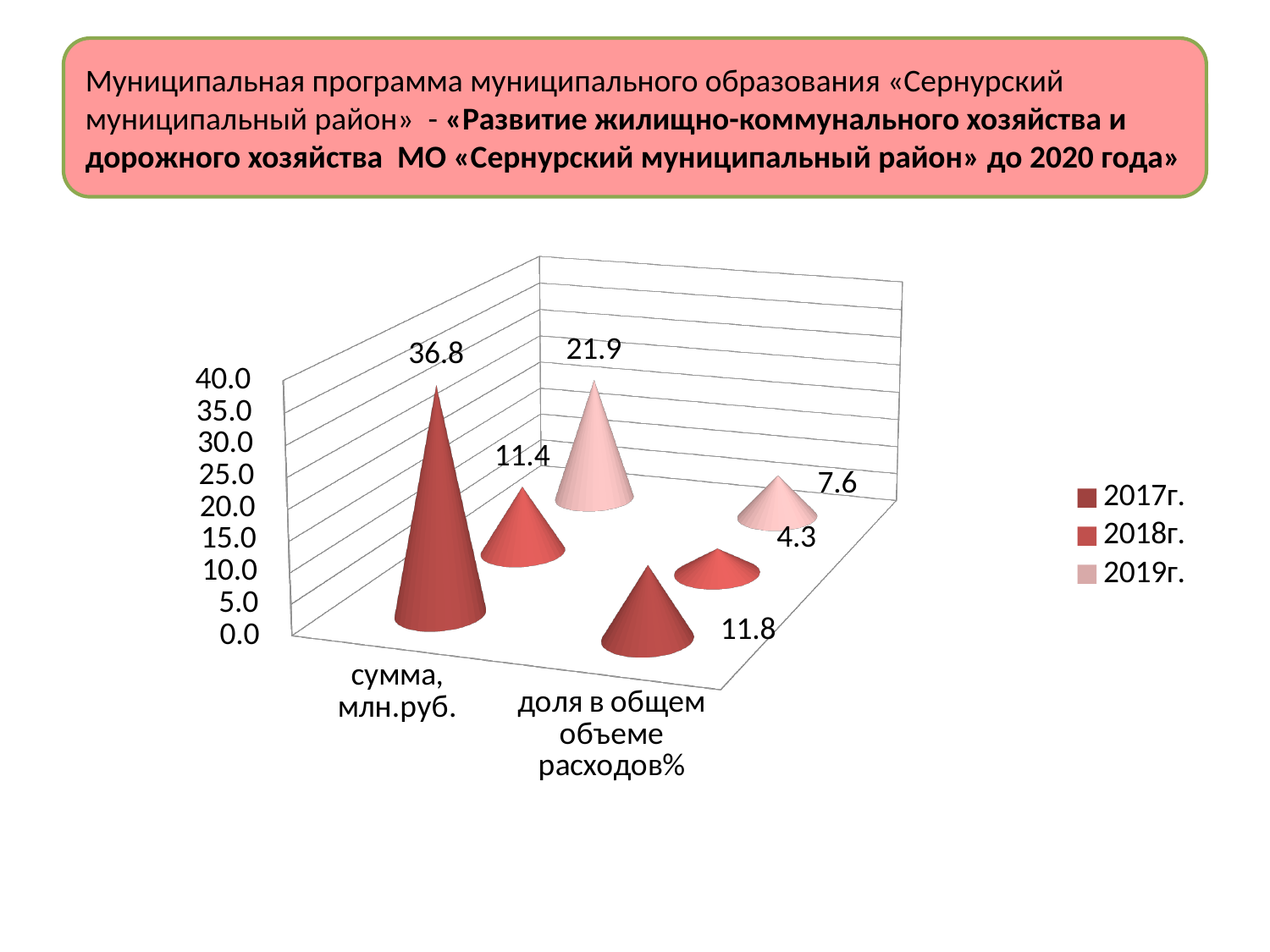
What is the value for 2018г. in the category «сумма, млн.руб.»? 11.4 What is the value for 2018г. in the category «доля в общем объеме расходов%»? 4.3 What is the difference between the 2017г. and 2019г. values in the category «сумма, млн.руб.»? 14.9 How many categories are shown on the x axis? 2 Which year has the lowest value in the category «доля в общем объеме расходов%»? 2018г. What is the value for 2019г. in the category «доля в общем объеме расходов%»? 7.6 What is the value for 2019г. in the category «сумма, млн.руб.»? 21.9 How many series does the legend list? 3 Which is larger in the category «доля в общем объеме расходов%»: the value for 2019г. or the value for 2018г.? 2019г. What is the value for 2017г. in the category «доля в общем объеме расходов%»? 11.8 What is the value for 2017г. in the category «сумма, млн.руб.»? 36.8 Which year has the highest value in the category «сумма, млн.руб.»? 2017г.